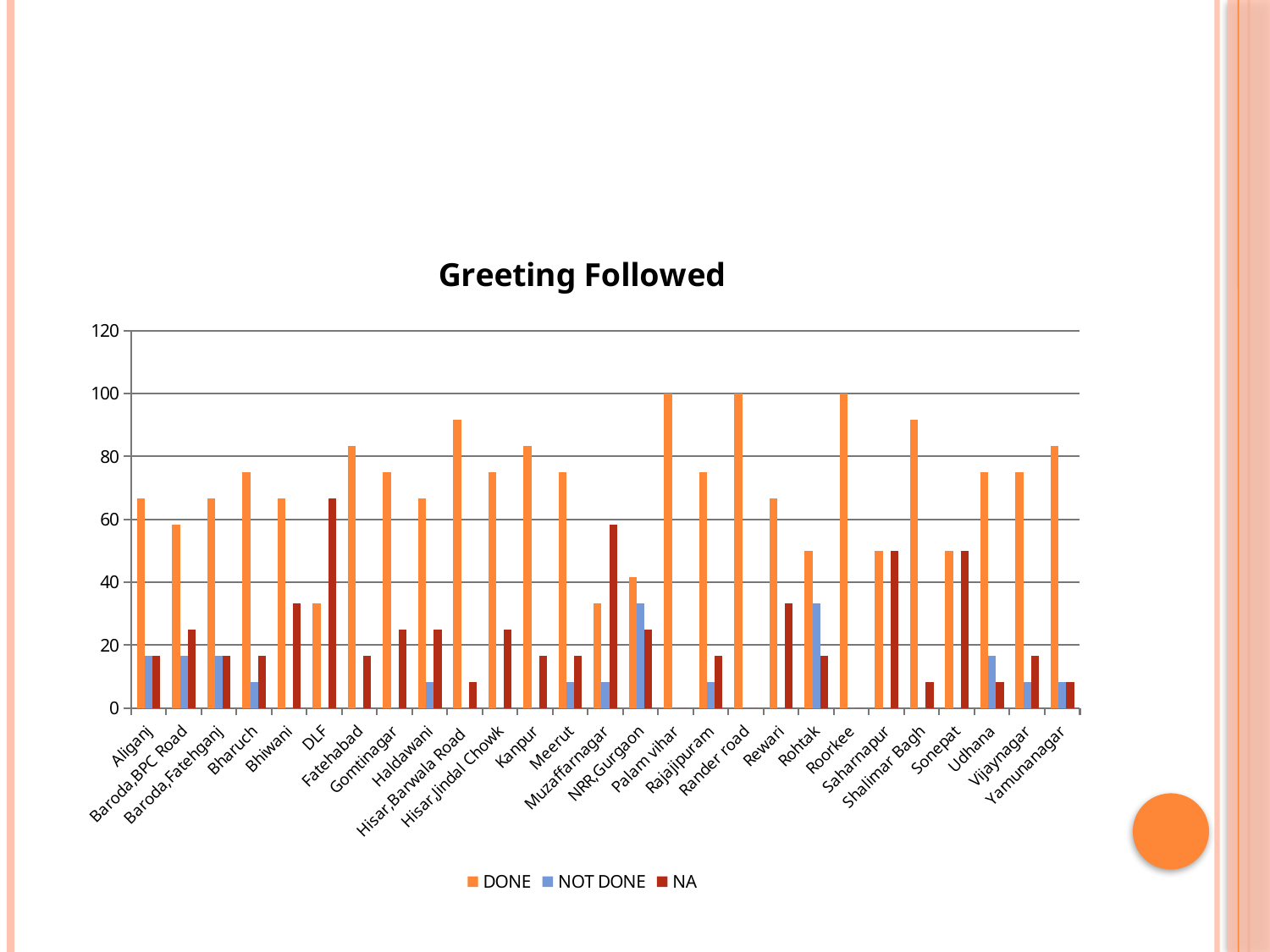
What is the DONE value for Palam vihar? 100 Which is larger, the DONE value for Rander road or the DONE value for Rewari? Rander road Is the NA value for Muzaffarnagar greater or less than 40? greater How many series does the legend list? 3 What is the DONE value for Roorkee? 100 What is the title of the chart? Greeting Followed Is the DONE value for DLF greater or less than 40? less What kind of chart is shown on the slide? bar chart Is the DONE value for Hisar,Barwala Road greater or less than 80? greater How many categories are shown on the x axis? 27